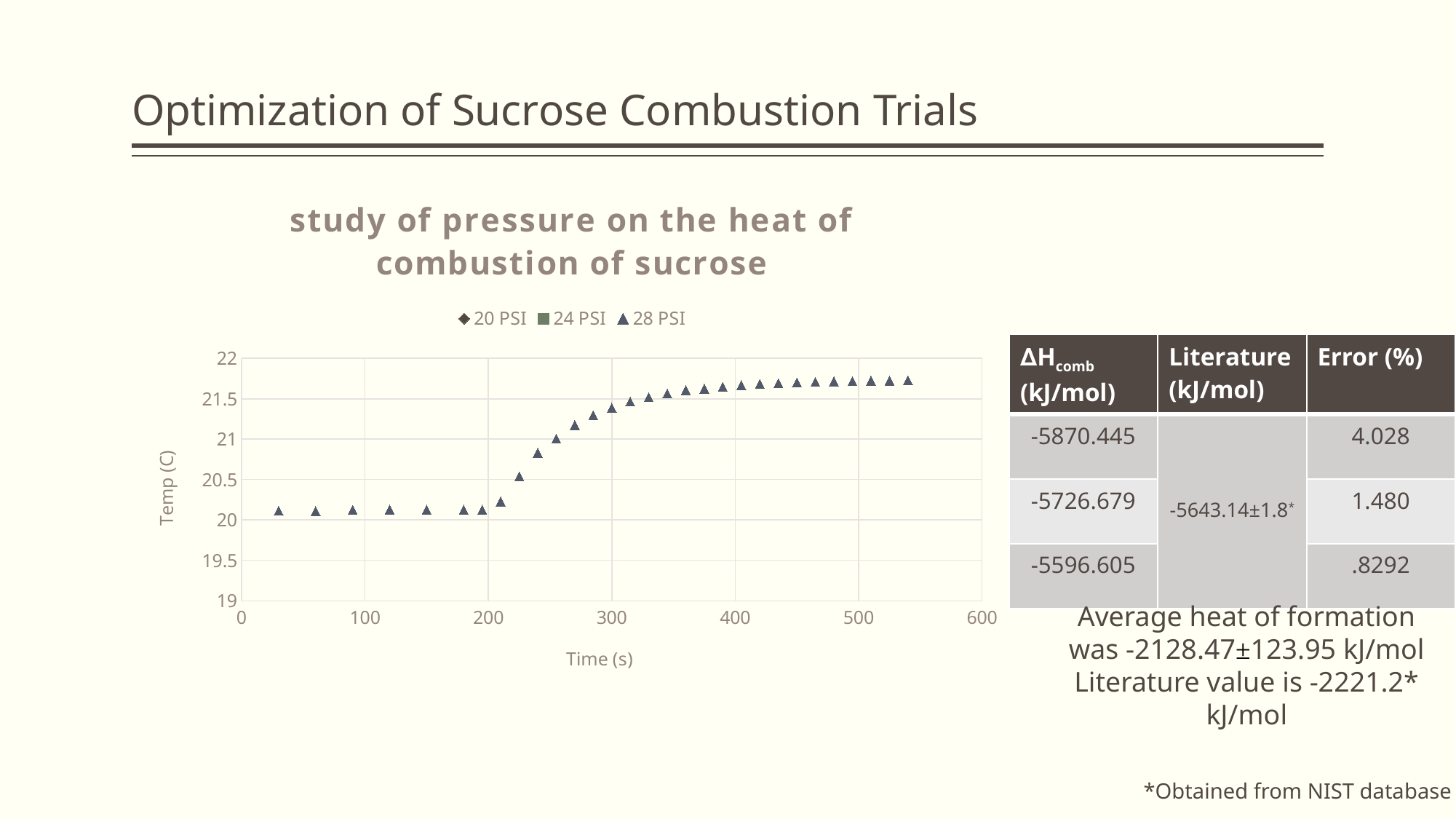
Do the plotted temperature values rise or fall as time increases along the x axis? rise Is the temperature value at about 540 s greater or less than 21.5? greater What are the series names listed in the chart legend? 20 PSI, 24 PSI, 28 PSI Which is larger, the temperature at about 100 s or the temperature at about 500 s? 500 s What is the title of the chart? study of pressure on the heat of combustion of sucrose What kind of chart is shown on the slide? scatter chart Is the temperature value at about 400 s greater or less than 21? greater Is the temperature value at about 300 s greater or less than 21? greater How many series does the chart legend list? 3